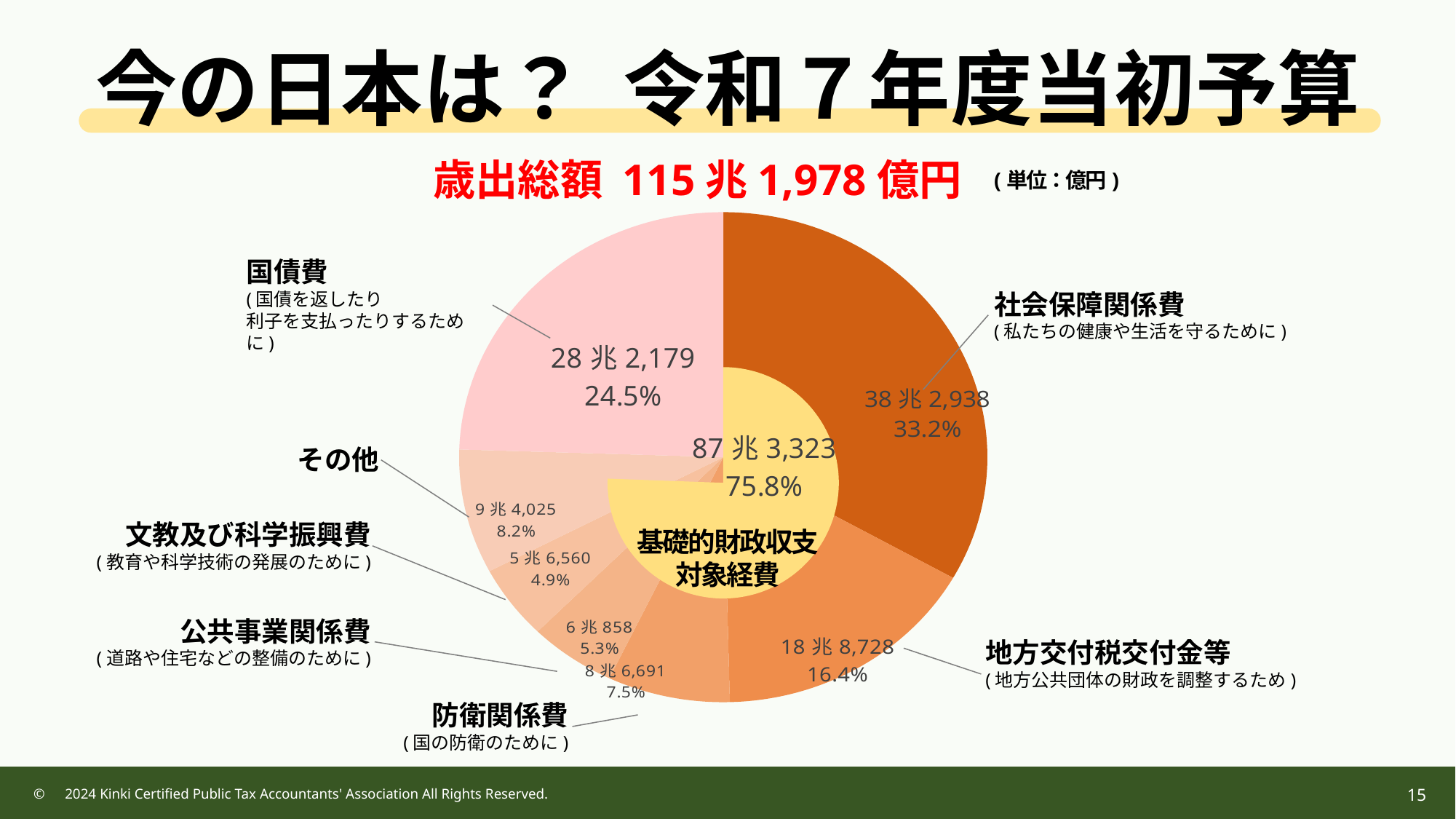
What percentage is shown in the centre for 基礎的財政収支対象経費? 75.8% What percentage share does 国債費 have? 24.5% Which category has the smallest share of the pie? 文教及び科学振興費 What is the value shown for 社会保障関係費? 38兆2,938 What is the value shown for 文教及び科学振興費? 5兆6,560 What kind of chart is shown on the slide? Pie chart (doughnut) How many expenditure categories are shown in the outer ring of the pie? 7 Which is larger, その他 or 公共事業関係費? その他 Which category has the largest share of the pie? 社会保障関係費 What is the difference in percentage points between 社会保障関係費 (33.2%) and 国債費 (24.5%)? 8.7% What is the value shown for 地方交付税交付金等? 18兆8,728 What percentage is shown for 防衛関係費? 7.5%